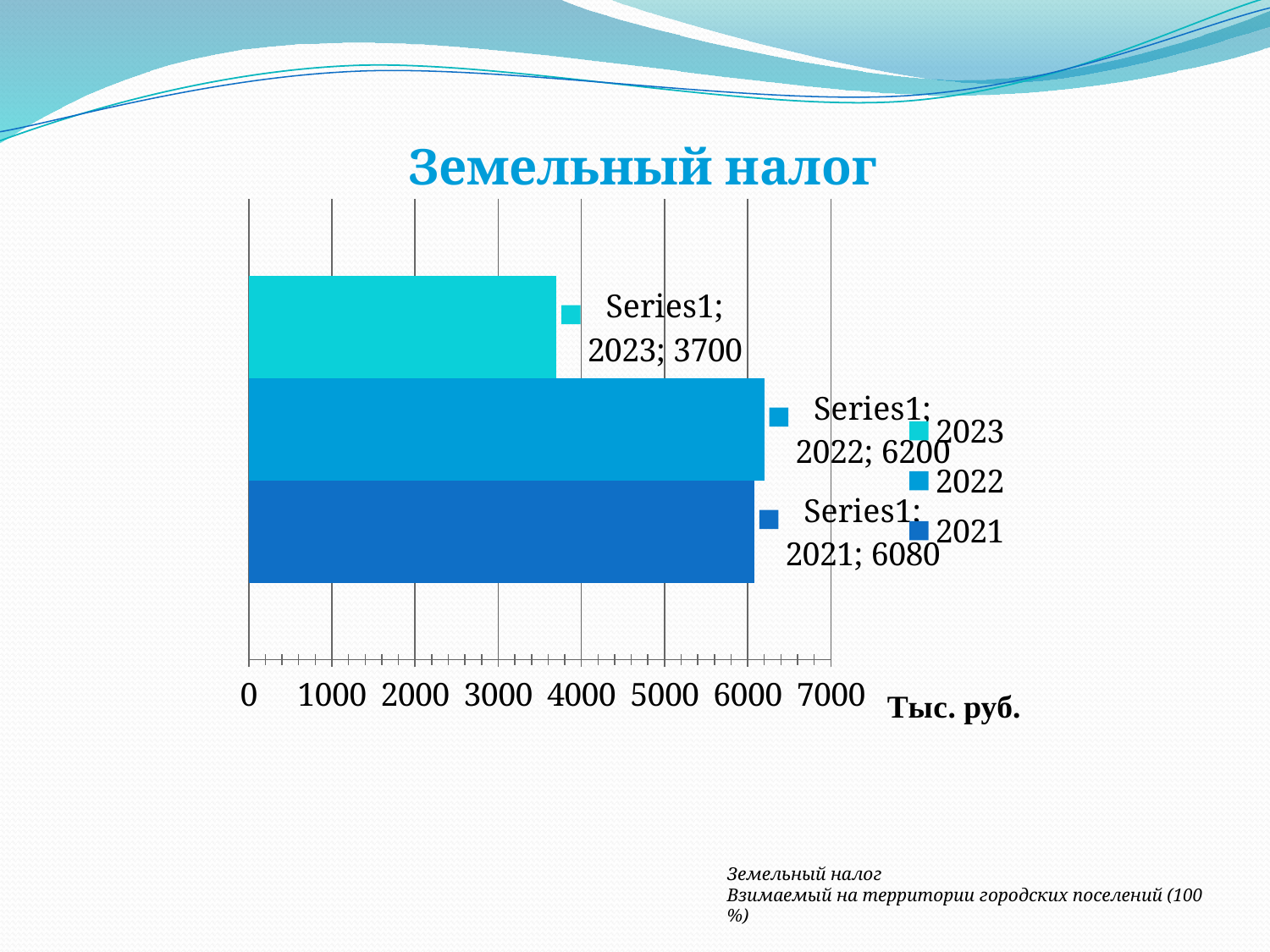
Which year has the lowest value in the Земельный налог chart? 2023 What is the value for 2022 in the Земельный налог chart? 6200 How many bars are plotted in the Земельный налог chart? 3 What is the value for 2021 in the Земельный налог chart? 6080 What unit label is shown next to the horizontal axis of the Земельный налог chart? Тыс. руб. What kind of chart is shown on the slide? bar chart What is the difference between the values for 2022 and 2023 in the Земельный налог chart? 2500 What is the value for 2023 in the Земельный налог chart? 3700 What is the difference between the values for 2022 and 2021 in the Земельный налог chart? 120 Which year has the highest value in the Земельный налог chart? 2022 Which is larger in the Земельный налог chart, the value for 2021 or the value for 2023? 2021 Is the value for 2023 in the Земельный налог chart greater or less than 4000? less